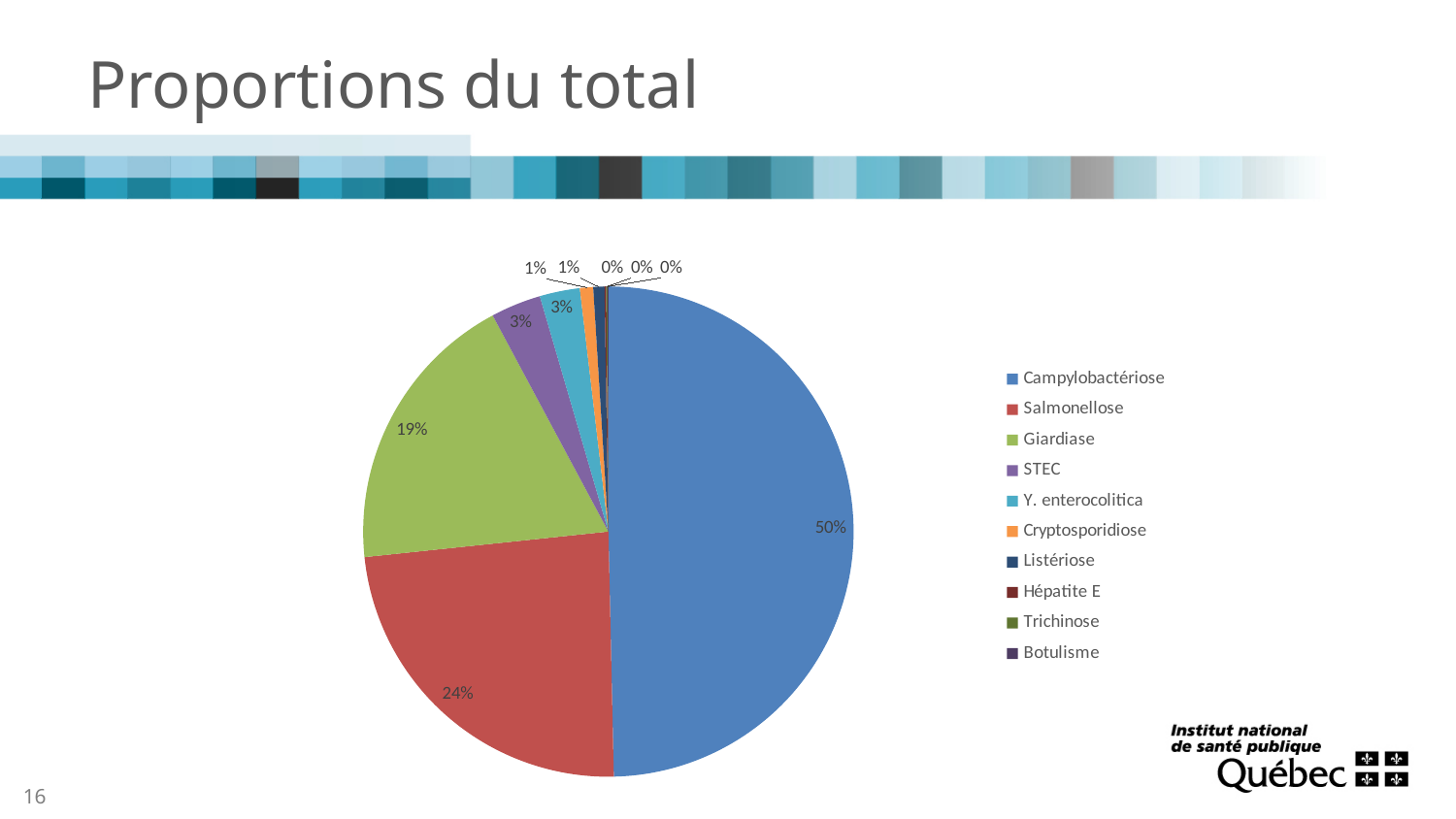
What colour is the Giardiase slice in the pie chart? Green What is the difference between the share for Campylobactériose and the share for Salmonellose? 26 percentage points How many categories does the legend list? 10 What share of the pie does Salmonellose represent? 24% What share of the pie does Campylobactériose represent? 50% What share of the pie does Cryptosporidiose represent? 1% What is the title of the slide containing the pie chart? Proportions du total Which is larger, the share for Salmonellose or the share for Giardiase? Salmonellose What kind of chart is shown on the slide? Pie chart Which category has the largest slice of the pie? Campylobactériose